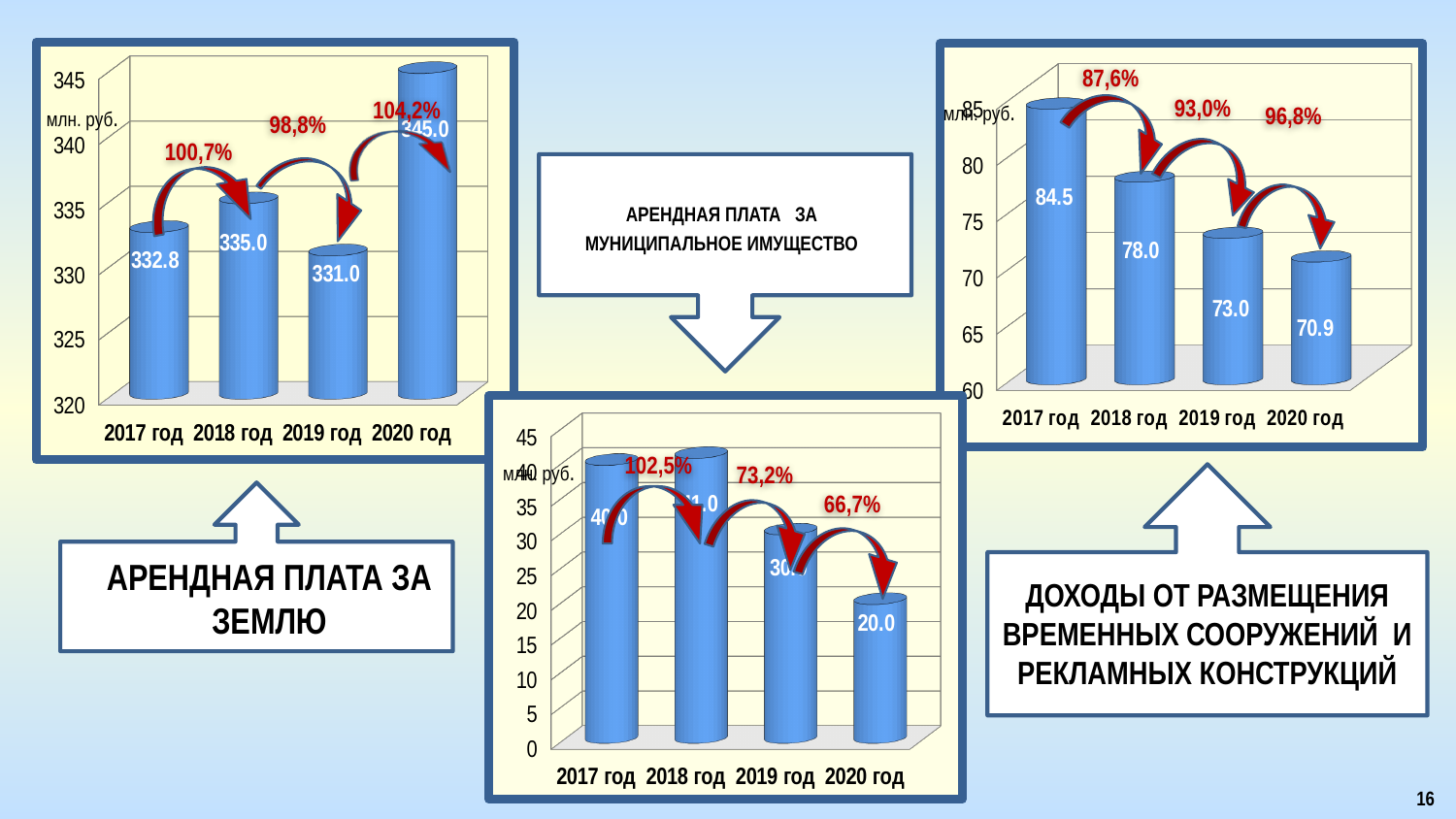
On the chart for 'Арендная плата за землю', which year has the lowest value? 2019 год On the chart for 'Доходы от размещения временных сооружений и рекламных конструкций', what is the difference between the 2017 год and 2018 год values? 6.5 On the chart for 'Арендная плата за землю', what is the difference between the 2018 год and 2017 год values? 2.2 On the chart for 'Арендная плата за муниципальное имущество', what is the value for 2020 год? 20.0 On the chart for 'Доходы от размещения временных сооружений и рекламных конструкций', what is the value for 2020 год? 70.9 On the chart for 'Арендная плата за землю', what is the value for 2019 год? 331.0 On the chart for 'Доходы от размещения временных сооружений и рекламных конструкций', what is the value for 2017 год? 84.5 How many years are shown on the chart for 'Арендная плата за муниципальное имущество'? 4 On the chart for 'Арендная плата за землю', what percentage is shown above the arrow from 2019 год to 2020 год? 104,2% On the chart for 'Арендная плата за землю', which year has the highest value? 2020 год On the chart for 'Арендная плата за муниципальное имущество', is the value for 2019 год greater or less than 25? greater On the chart for 'Доходы от размещения временных сооружений и рекламных конструкций', do the values rise or fall from 2017 год to 2020 год? fall